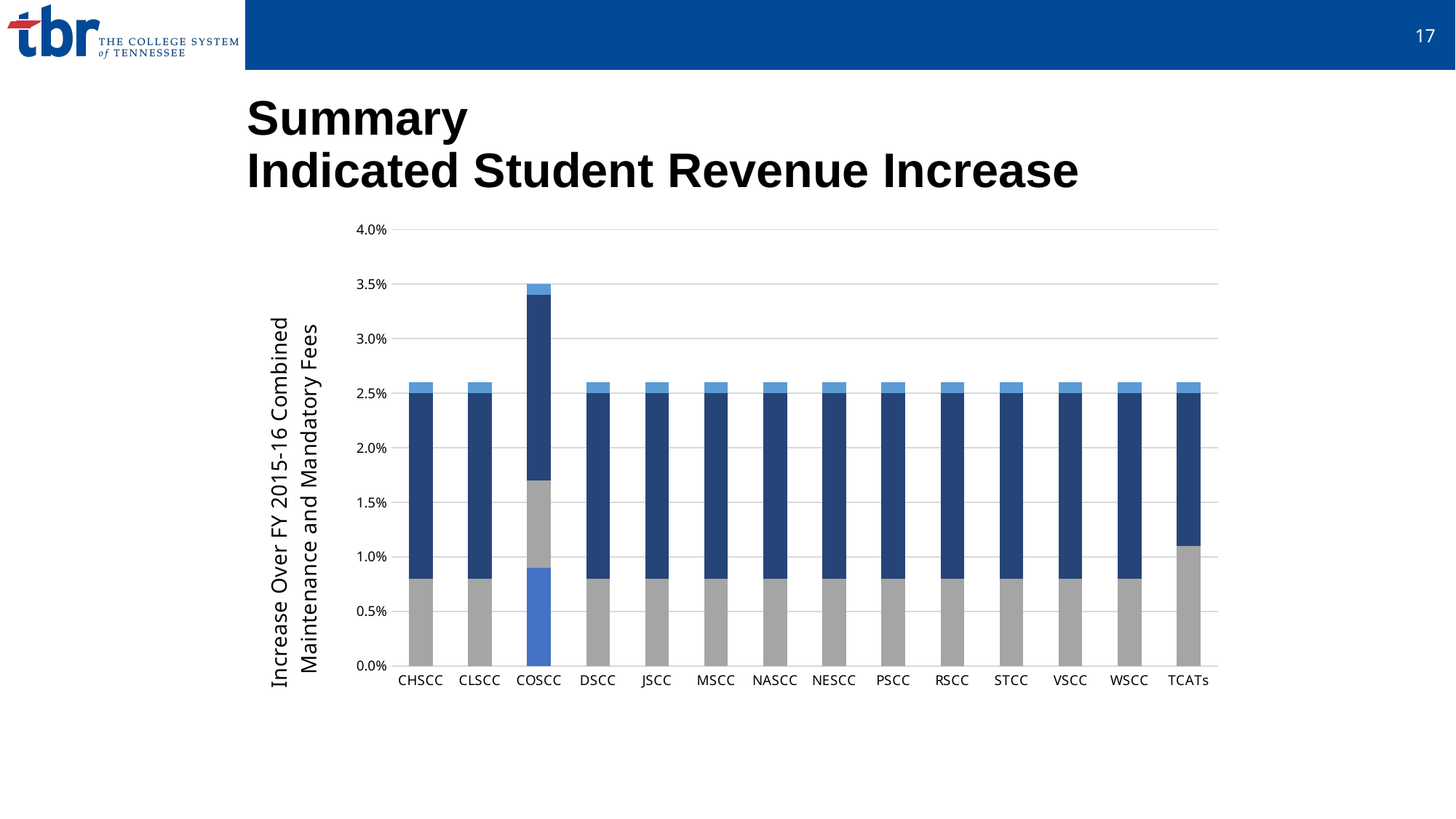
Is the bottom (gray) segment of the CHSCC bar greater or less than 1.0%? less Is the total bar for COSCC larger or smaller than the total bar for DSCC? larger Which institution has the highest total bar in the chart? COSCC What is the highest value shown on the vertical axis of the chart? 4.0% How many institutions (categories) are shown along the x axis of the chart? 14 Is the bottom (gray) segment of the TCATs bar larger or smaller than the bottom (gray) segment of the WSCC bar? larger What kind of chart is shown on the slide? Stacked bar chart What is the label on the vertical axis of the chart? Increase Over FY 2015-16 Combined Maintenance and Mandatory Fees Is the total bar for COSCC greater or less than 3.0%? greater Is the total bar for CHSCC greater or less than 3.0%? less